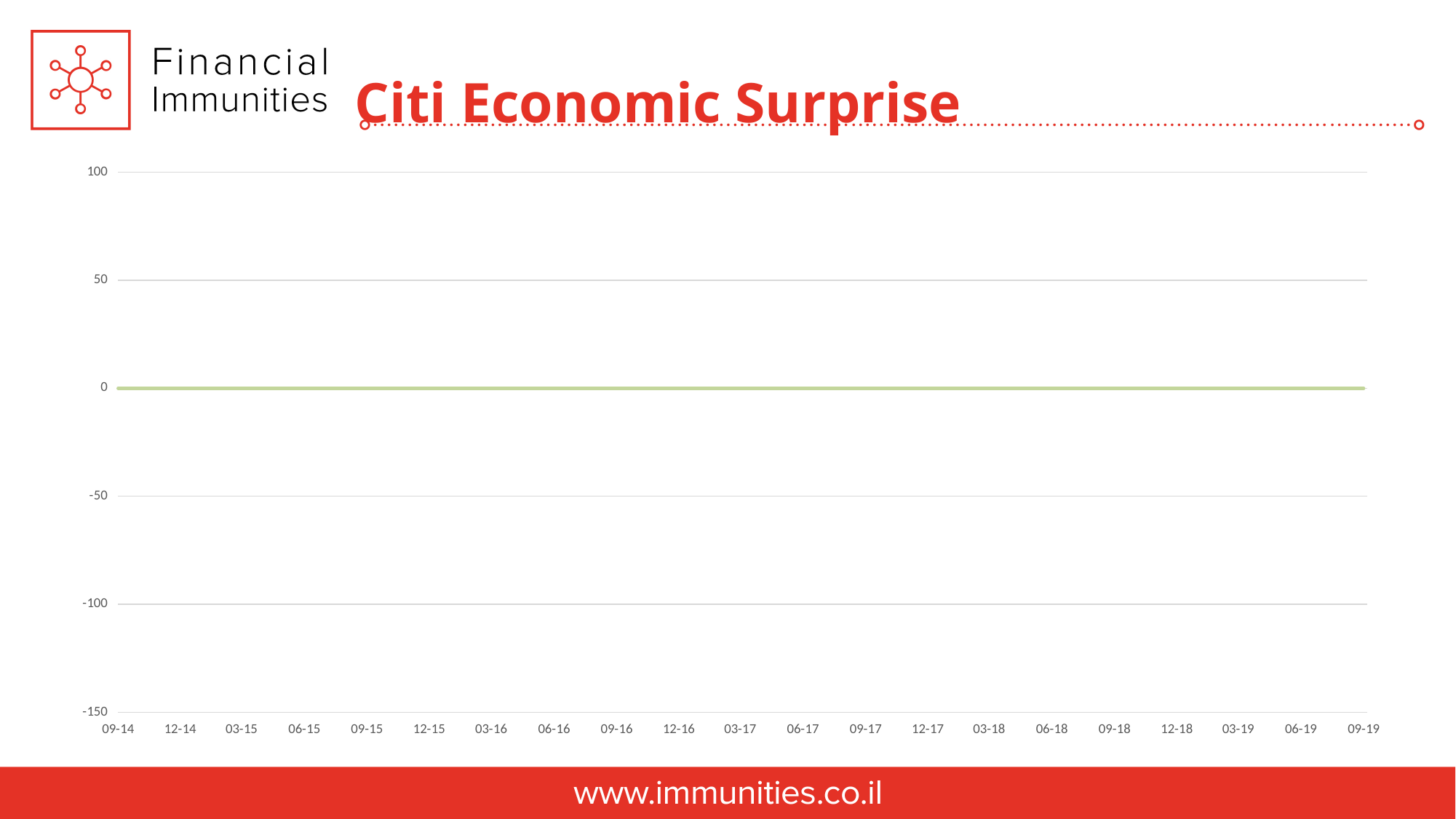
Is the value for 09-16 greater or less than 50? less What kind of chart is shown on the slide? line chart Is the value for 06-19 greater or less than 100? less What is the title of the chart? Citi Economic Surprise What value does the plotted line sit on across the whole period? 0 Does the plotted line rise, fall, or stay flat from 09-14 to 09-19? stay flat What colour is the plotted line? green What is the lowest value shown on the y axis? -150 How many date labels are shown along the x axis? 21 What is the highest value shown on the y axis? 100 Is the value for 03-18 greater or less than -50? greater What is the first date label on the x axis? 09-14